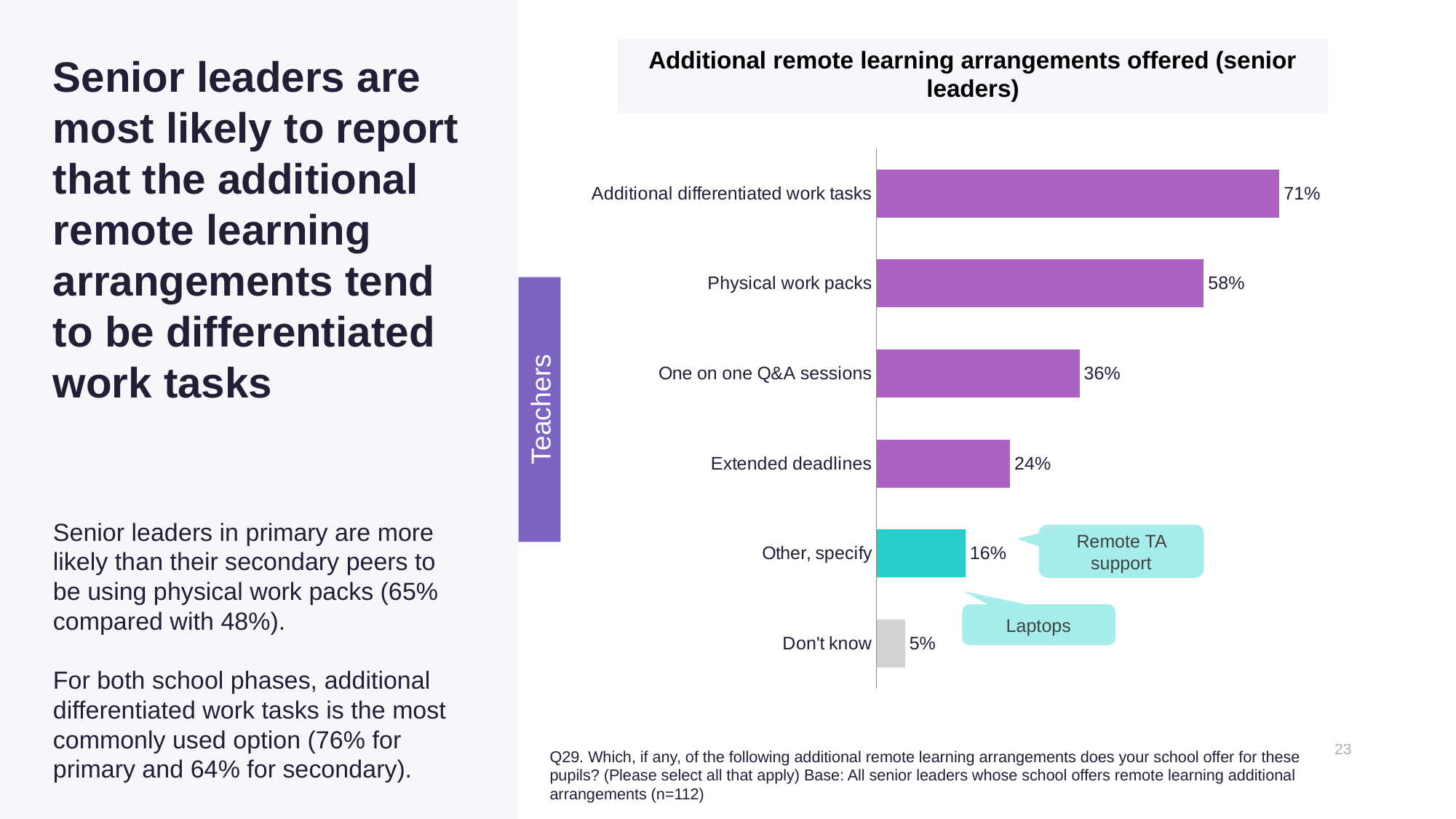
What percentage is shown for One on one Q&A sessions? 36% What type of chart is shown on the slide? Bar chart Which is larger: the value for One on one Q&A sessions or Extended deadlines? One on one Q&A sessions Which category has the lowest value? Don't know What is the title of the chart? Additional remote learning arrangements offered (senior leaders) How many categories are shown in the chart? 6 What percentage is shown for Don't know? 5% What percentage of senior leaders report offering additional differentiated work tasks? 71% What is the value for Extended deadlines? 24% What is the difference between the values for Additional differentiated work tasks and Physical work packs? 13% What is the value for Physical work packs? 58% Which category has the highest value? Additional differentiated work tasks